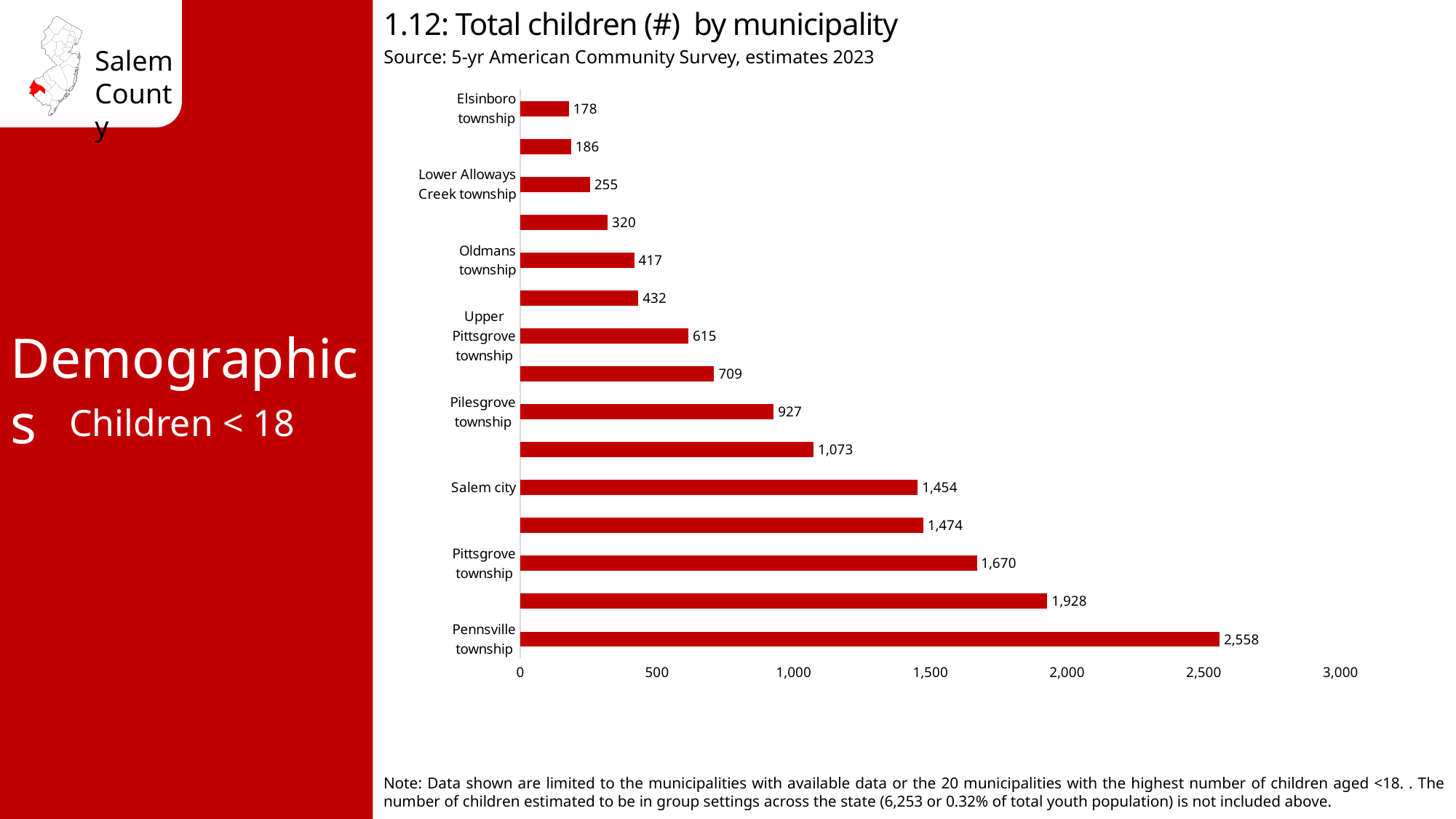
How many bars are plotted in the chart? 15 What is the total number of children for Pennsville township? 2,558 Which municipality has the lowest number of children? Elsinboro township What is the difference in the number of children between Pilesgrove township and Lower Alloways Creek township? 672 What kind of chart is shown on the slide? Bar chart What is the difference in the number of children between Pennsville township and Pittsgrove township? 888 What is the total number of children for Oldmans township? 417 Is the value for Pilesgrove township greater or less than 1,000? less Which municipality has the highest number of children? Pennsville township What is the total number of children for Salem city? 1,454 Which has more children, Salem city or Pittsgrove township? Pittsgrove township What is the total number of children for Upper Pittsgrove township? 615